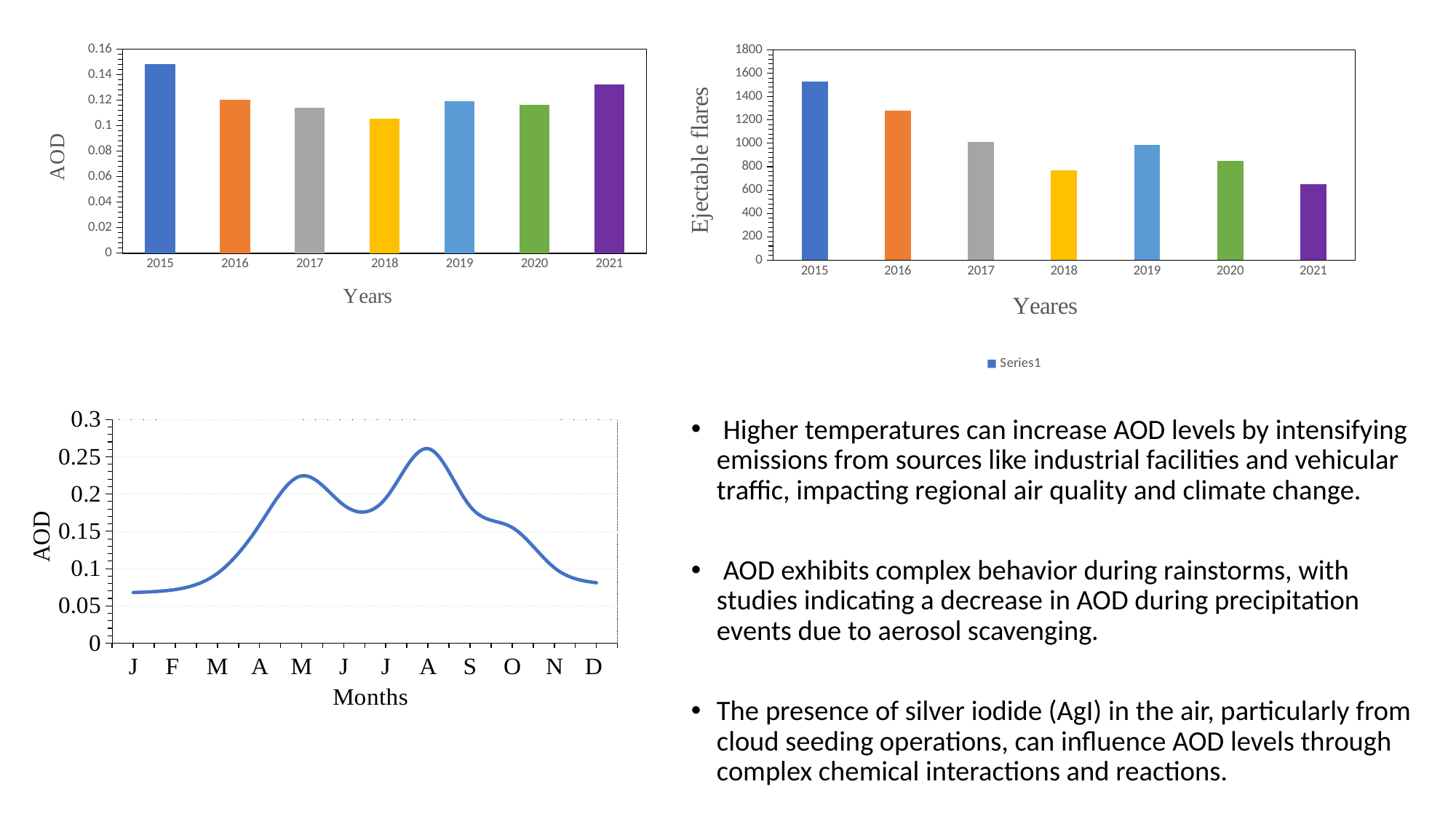
In the top-right Ejectable flares chart, how many series does the legend list? 1 In the top-left AOD chart, which year has the lowest AOD value? 2018 In the top-right Ejectable flares chart, is the value for 2021 greater or less than 800? less In the top-left AOD chart, how many years are shown on the x axis? 7 In the bottom-left AOD by month chart, in which month does AOD reach its highest value? A (August) In the top-right Ejectable flares chart, is the value for 2019 larger or smaller than the value for 2018? larger In the top-right Ejectable flares chart, which year has the lowest value? 2021 In the top-left AOD chart, which year has the highest AOD value? 2015 In the top-left AOD chart, is the value for 2015 greater or less than 0.14? greater In the top-left AOD chart, is the AOD value for 2021 larger or smaller than the value for 2016? larger What kind of chart is the bottom-left chart of AOD by month? line chart In the top-right Ejectable flares chart, which year has the highest value? 2015